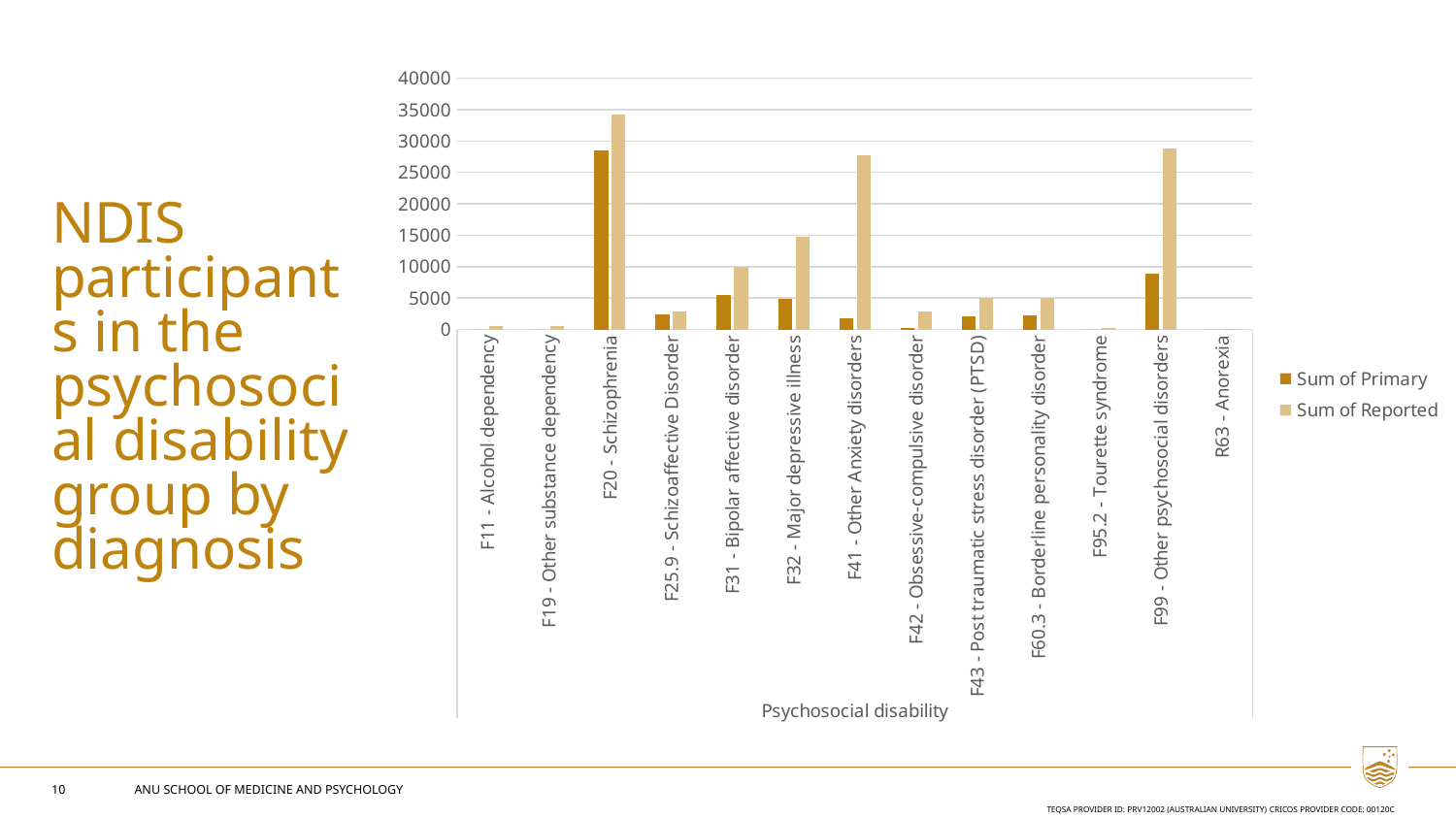
Which diagnosis has the highest Sum of Reported value? F20 - Schizophrenia Is the Sum of Reported value for F20 - Schizophrenia greater or less than 30000? greater How many diagnosis categories are shown on the x axis? 13 For F41 - Other Anxiety disorders, which is larger: Sum of Primary or Sum of Reported? Sum of Reported What kind of chart is shown on the slide? bar chart Which diagnosis has the highest Sum of Primary value? F20 - Schizophrenia Is the Sum of Reported value for F41 - Other Anxiety disorders greater or less than 25000? greater How many series does the legend list? 2 Which has the larger Sum of Reported value: F32 - Major depressive illness or F31 - Bipolar affective disorder? F32 - Major depressive illness Is the Sum of Primary value for F20 - Schizophrenia greater or less than 25000? greater What is the title of the x axis? Psychosocial disability